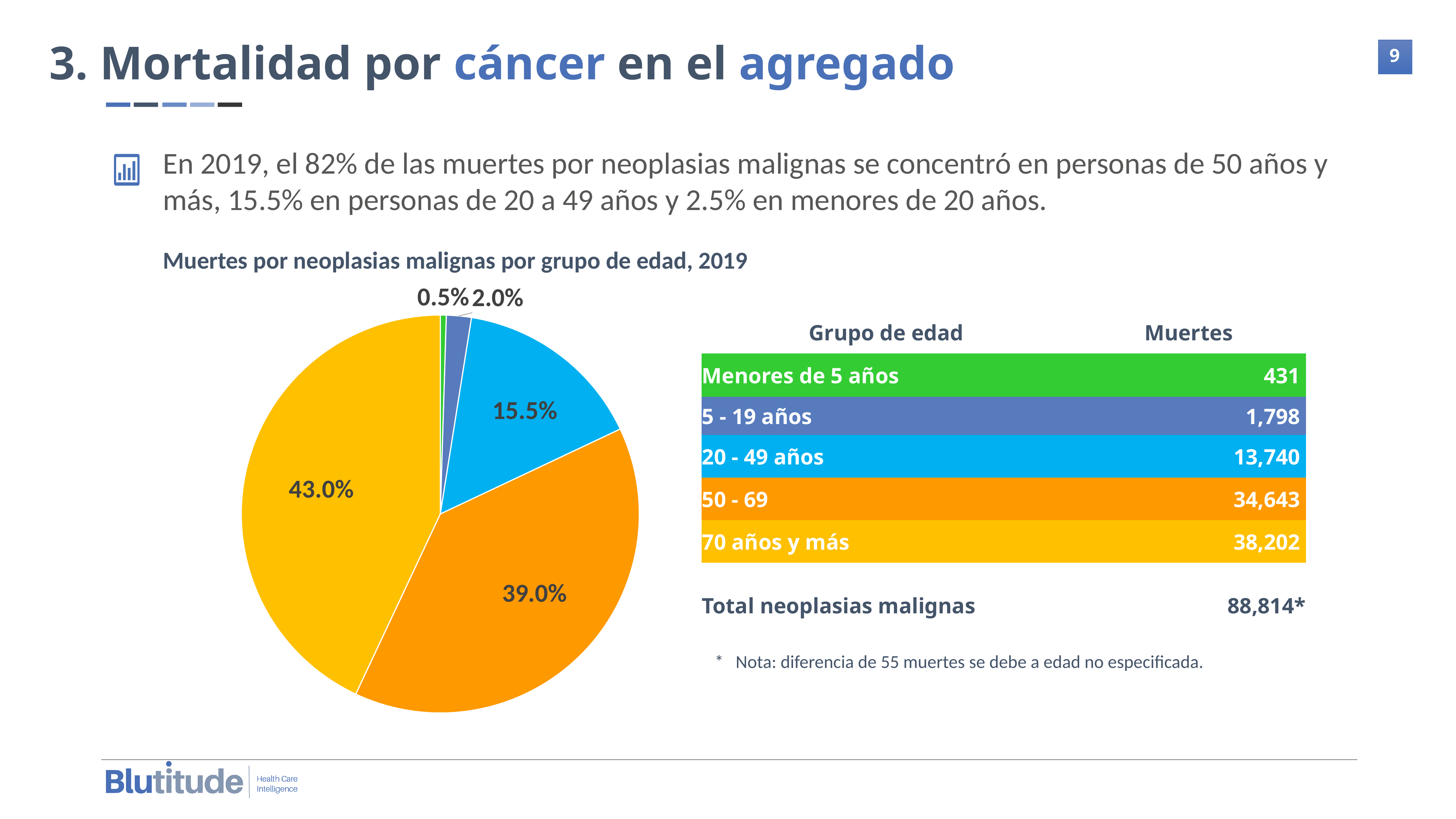
What share of the pie does the 20 - 49 años group (light blue slice) represent? 15.5% Which slice is larger, the 5 - 19 años slice or the Menores de 5 años slice? 5 - 19 años What is the title of the chart? Muertes por neoplasias malignas por grupo de edad, 2019 How many slices does the pie chart have? 5 What share of the pie does the 70 años y más group (yellow slice) represent? 43.0% What share of the pie does the 50 - 69 group (orange slice) represent? 39.0% What colour is the slice representing the 50 - 69 age group? Orange What is the difference in percentage points between the 70 años y más slice and the 50 - 69 slice? 4.0% What kind of chart is shown on the slide? Pie chart Which age group has the smallest slice of the pie? Menores de 5 años Which age group has the largest slice of the pie? 70 años y más